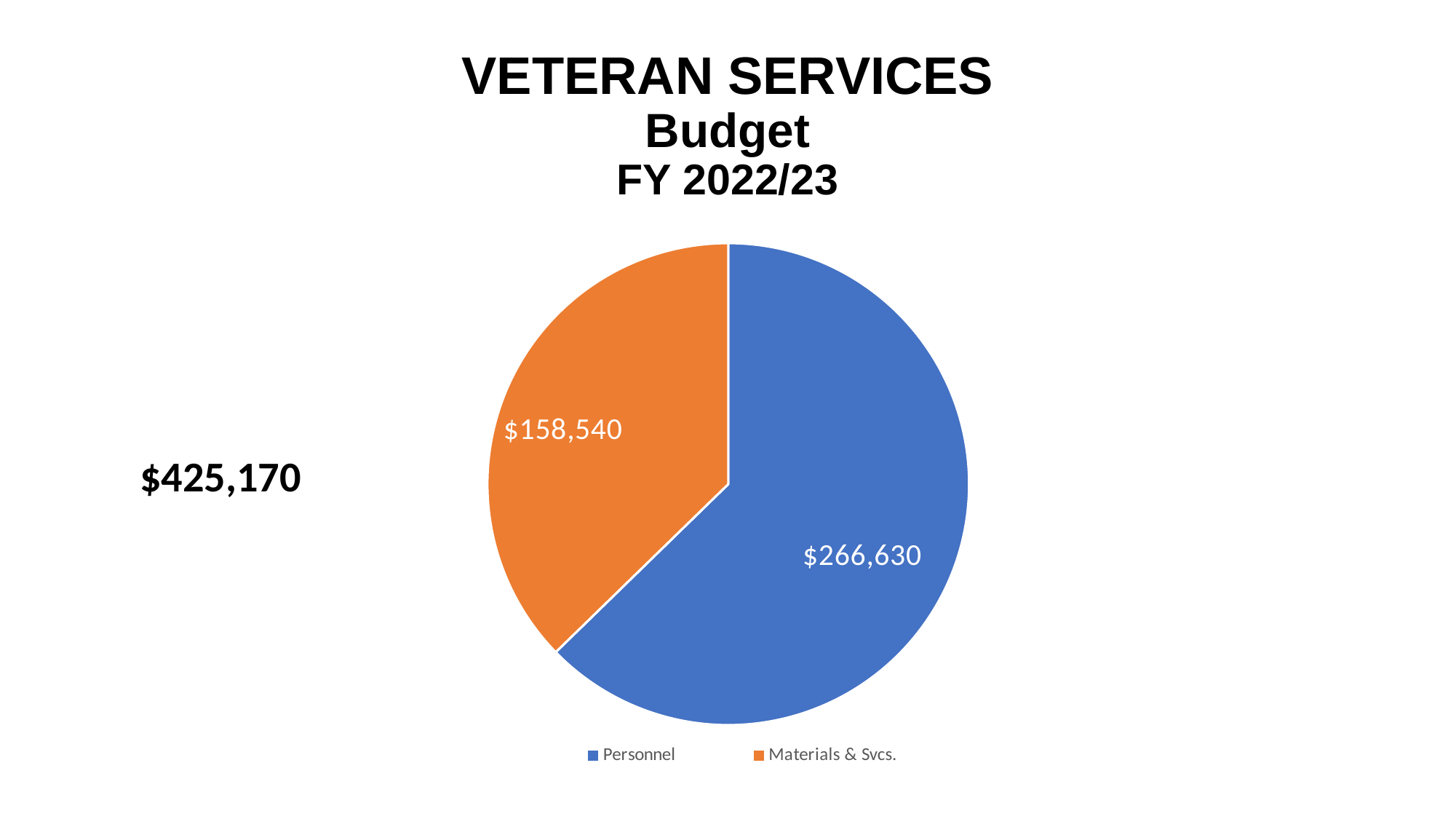
Which category has the smallest slice of the pie? Materials & Svcs. What share of the total budget does Personnel represent? 62.7% Which category has the largest slice of the pie? Personnel Which is larger, the Personnel value or the Materials & Svcs. value? Personnel What total budget figure is shown on the slide next to the pie chart? $425,170 What is the budget value for Personnel? $266,630 What is the budget value for Materials & Svcs.? $158,540 What is the difference between the Personnel value and the Materials & Svcs. value? $108,090 How many slices does the pie chart have? 2 How many entries does the legend list? 2 What colour is the Materials & Svcs. slice? Orange What type of chart is shown on the slide? Pie chart